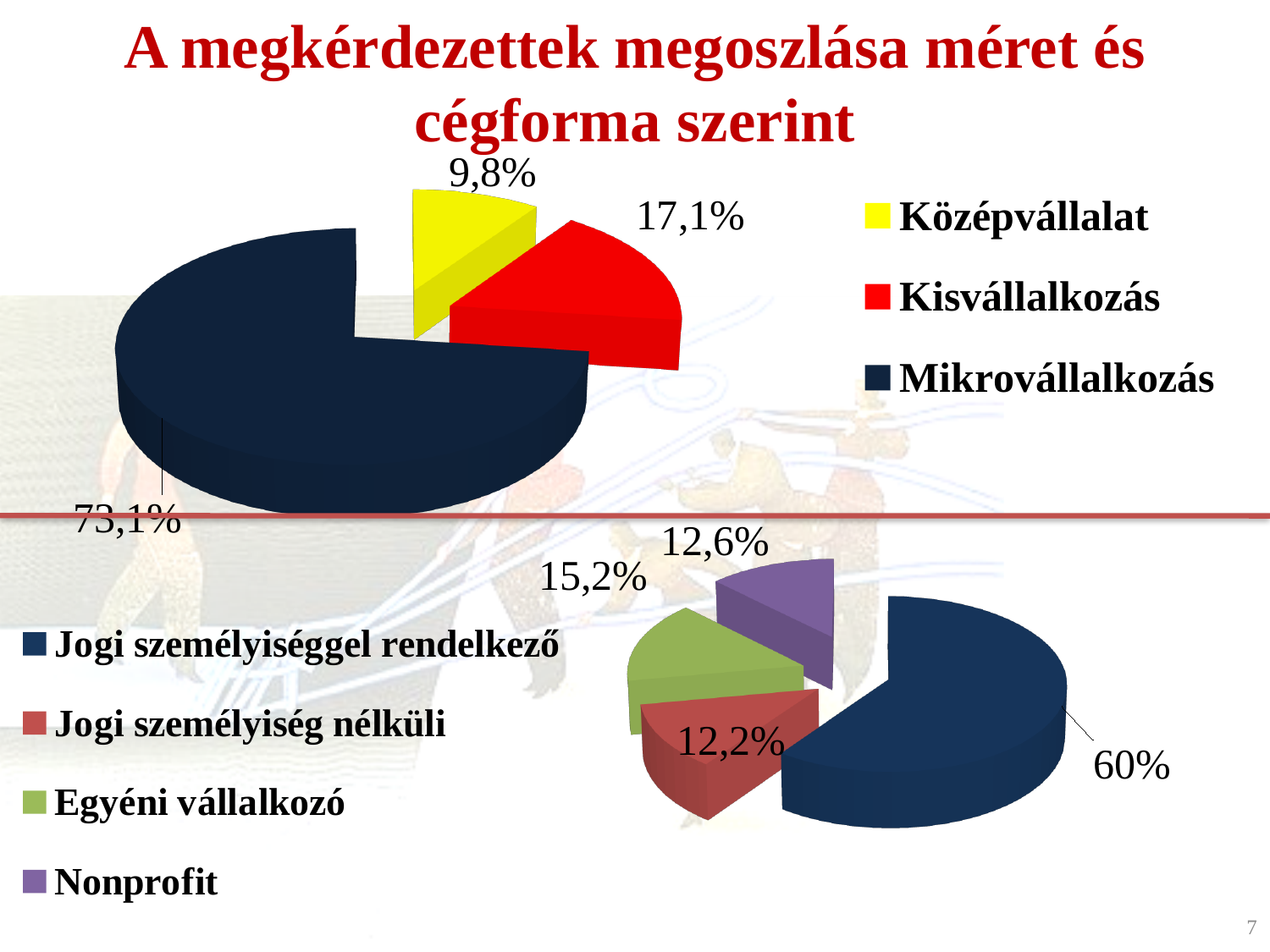
In the top pie chart, what share is labelled for Kisvállalkozás? 17,1% What type of chart is used for both charts on the slide? Pie chart In the top pie chart, what share is labelled for Mikrovállalkozás? 73,1% In the top pie chart, what is the difference between the Kisvállalkozás and Középvállalat shares? 7,3% In the top pie chart, which category has the smallest slice? Középvállalat In the top pie chart, which category has the largest slice? Mikrovállalkozás In the bottom pie chart, what share is labelled for Egyéni vállalkozó? 15,2% In the bottom pie chart, what share is labelled for Nonprofit? 12,6% In the top pie chart, what share is labelled for Középvállalat? 9,8% How many categories does the legend of the bottom pie chart list? 4 In the bottom pie chart, which is larger, Egyéni vállalkozó or Jogi személyiség nélküli? Egyéni vállalkozó In the bottom pie chart, what share is labelled for Jogi személyiséggel rendelkező? 60%